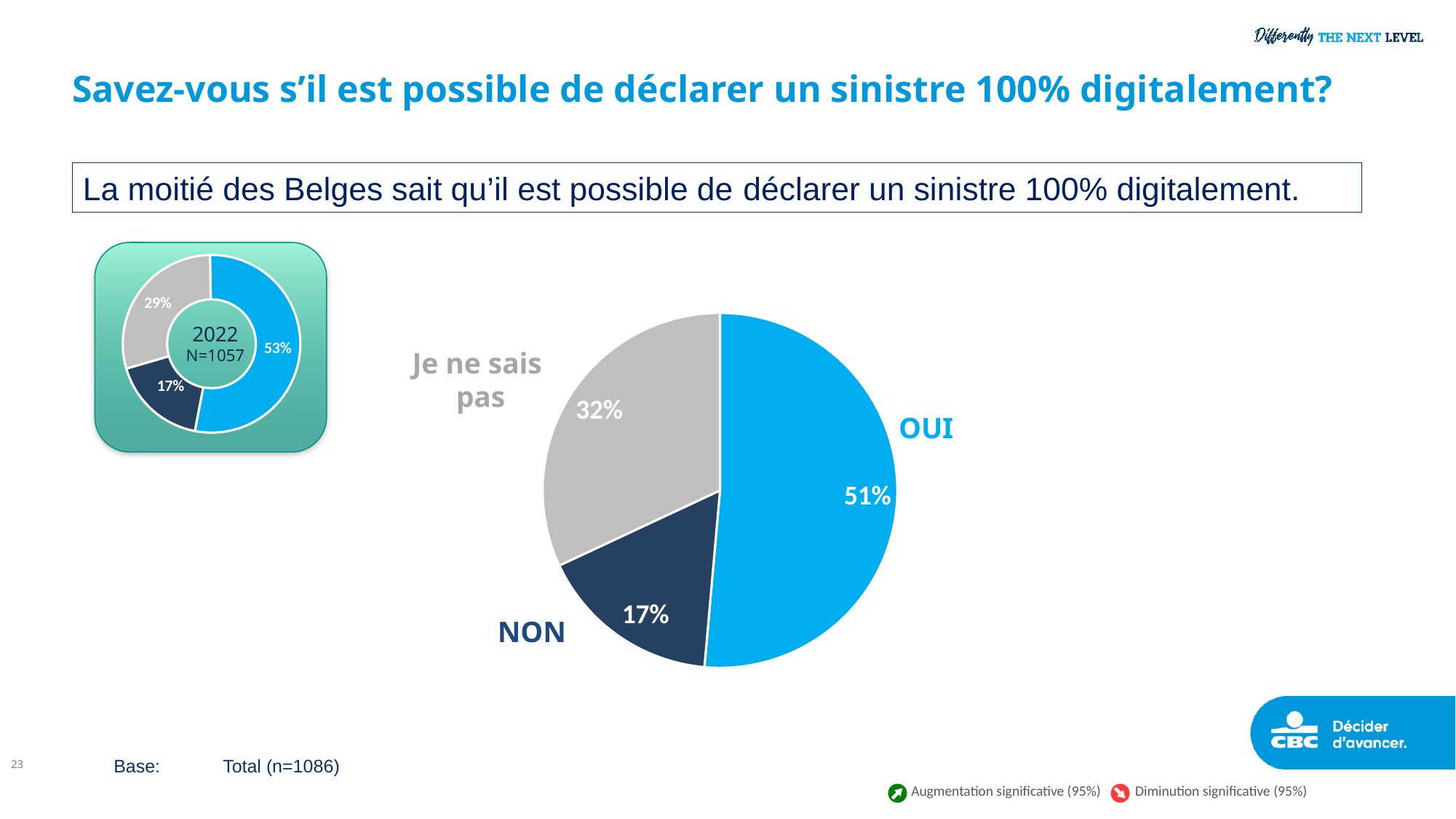
In the large pie chart, which answer has the smallest share? NON In the large pie chart, which answer has the largest share? OUI What type of chart is the large chart in the centre of the slide? Pie chart In the large pie chart, what percentage of respondents answered OUI? 51% In the large pie chart, what is the difference in percentage points between OUI and 'Je ne sais pas'? 19 In the large pie chart, which is larger: the share for NON or the share for 'Je ne sais pas'? Je ne sais pas What sample size (N) is shown in the centre of the small 2022 donut chart? N=1057 In the small 2022 donut chart on the left, what percentage is shown for the blue slice? 53% In the small 2022 donut chart on the left, what percentage is shown for the grey slice? 29% How many slices does the large pie chart have? 3 In the large pie chart, what percentage of respondents answered 'Je ne sais pas'? 32% In the large pie chart, what percentage of respondents answered NON? 17%